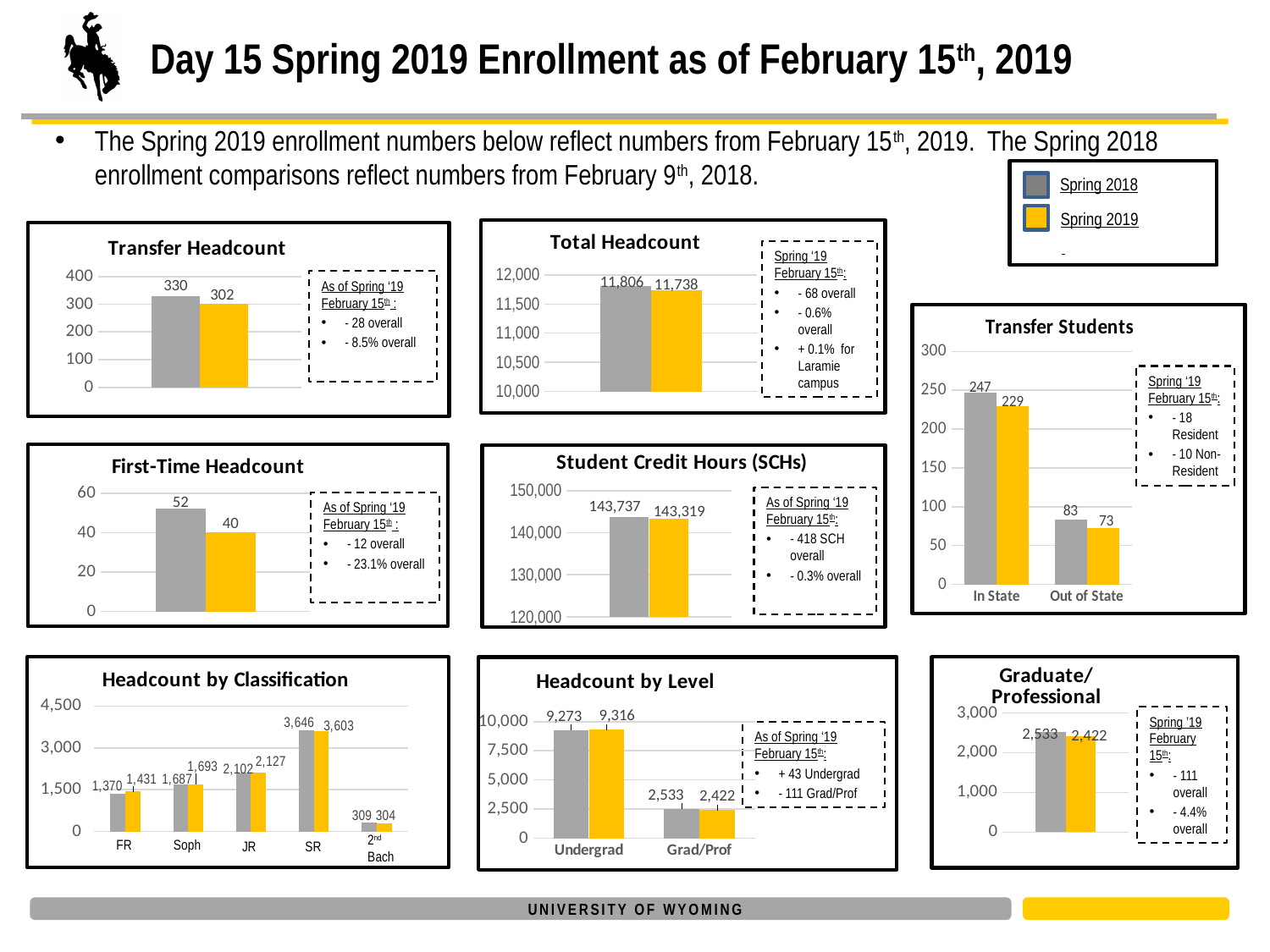
How many categories are shown on the x axis of the Headcount by Classification chart? 5 In the Headcount by Classification chart, which category has the lowest Spring 2018 value? 2nd Bach In the Headcount by Level chart, what is the Spring 2019 value for Undergrad? 9,316 In the Transfer Headcount chart, what is the Spring 2019 value? 302 How many series does the legend at the top right of the slide list? 2 In the Student Credit Hours (SCHs) chart, which is larger, the Spring 2018 value or the Spring 2019 value? Spring 2018 What kind of chart is the Graduate/Professional chart? Bar chart In the Total Headcount chart, what is the Spring 2018 value? 11,806 In the Transfer Students chart, what is the Spring 2019 value for Out of State? 73 In the Headcount by Level chart, what is the difference between the Spring 2018 and Spring 2019 values for Grad/Prof? 111 In the First-Time Headcount chart, what is the difference between the Spring 2018 and Spring 2019 values? 12 In the Headcount by Classification chart, which category has the highest Spring 2019 value? SR